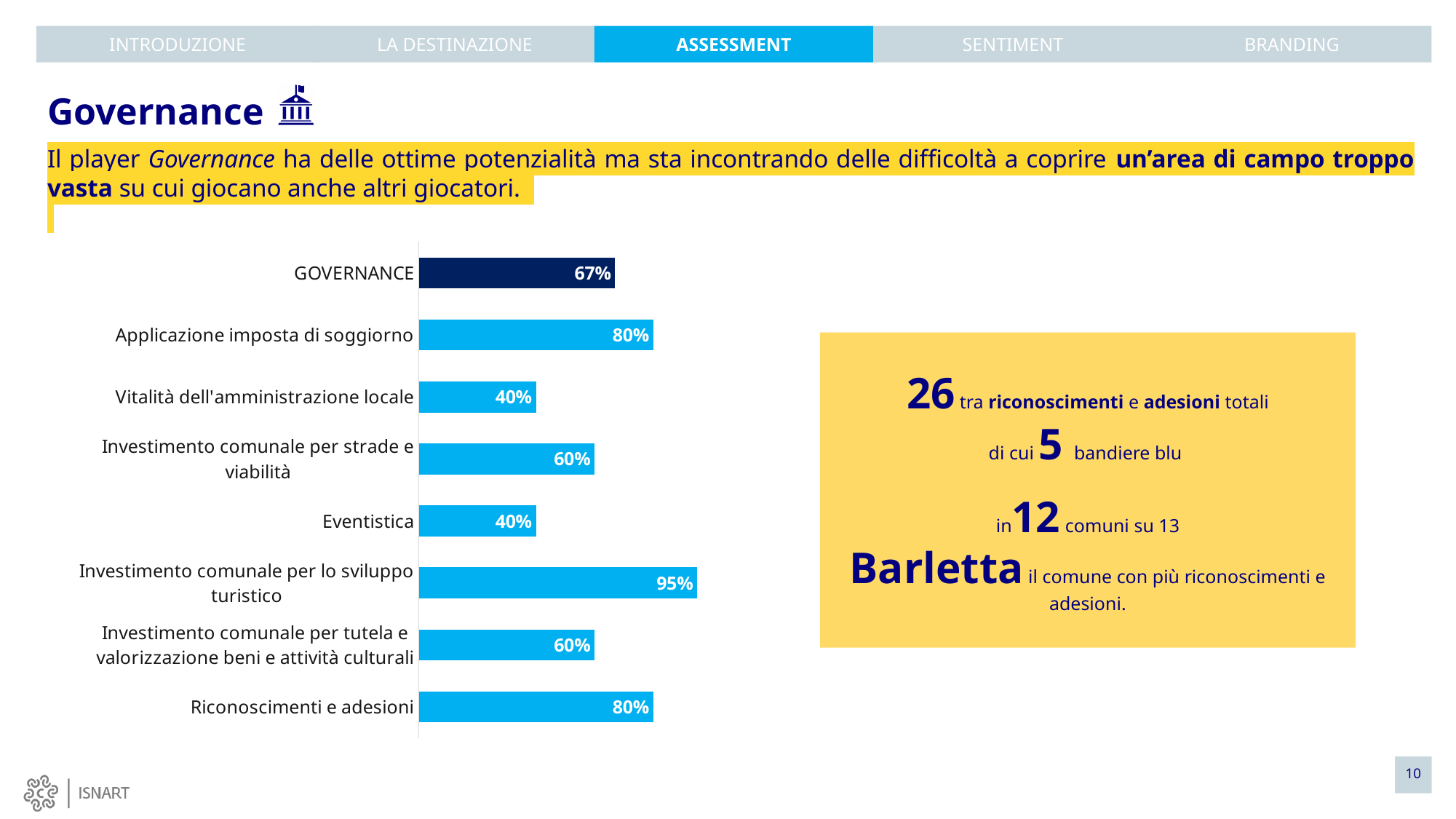
Which is larger, Investimento comunale per strade e viabilità or Riconoscimenti e adesioni? Riconoscimenti e adesioni What is the value for Investimento comunale per tutela e valorizzazione beni e attività culturali? 60% What is the value for Applicazione imposta di soggiorno? 80% What is the difference between Applicazione imposta di soggiorno and GOVERNANCE? 13% What is the difference between Investimento comunale per lo sviluppo turistico and Vitalità dell'amministrazione locale? 55% What is the value for Investimento comunale per lo sviluppo turistico? 95% What is the value for Eventistica? 40% What kind of chart is shown on the slide? Bar chart Which category has the highest value? Investimento comunale per lo sviluppo turistico Which bar is shown in a darker colour than the others? GOVERNANCE How many categories are shown in the chart? 8 What is the value for GOVERNANCE? 67%